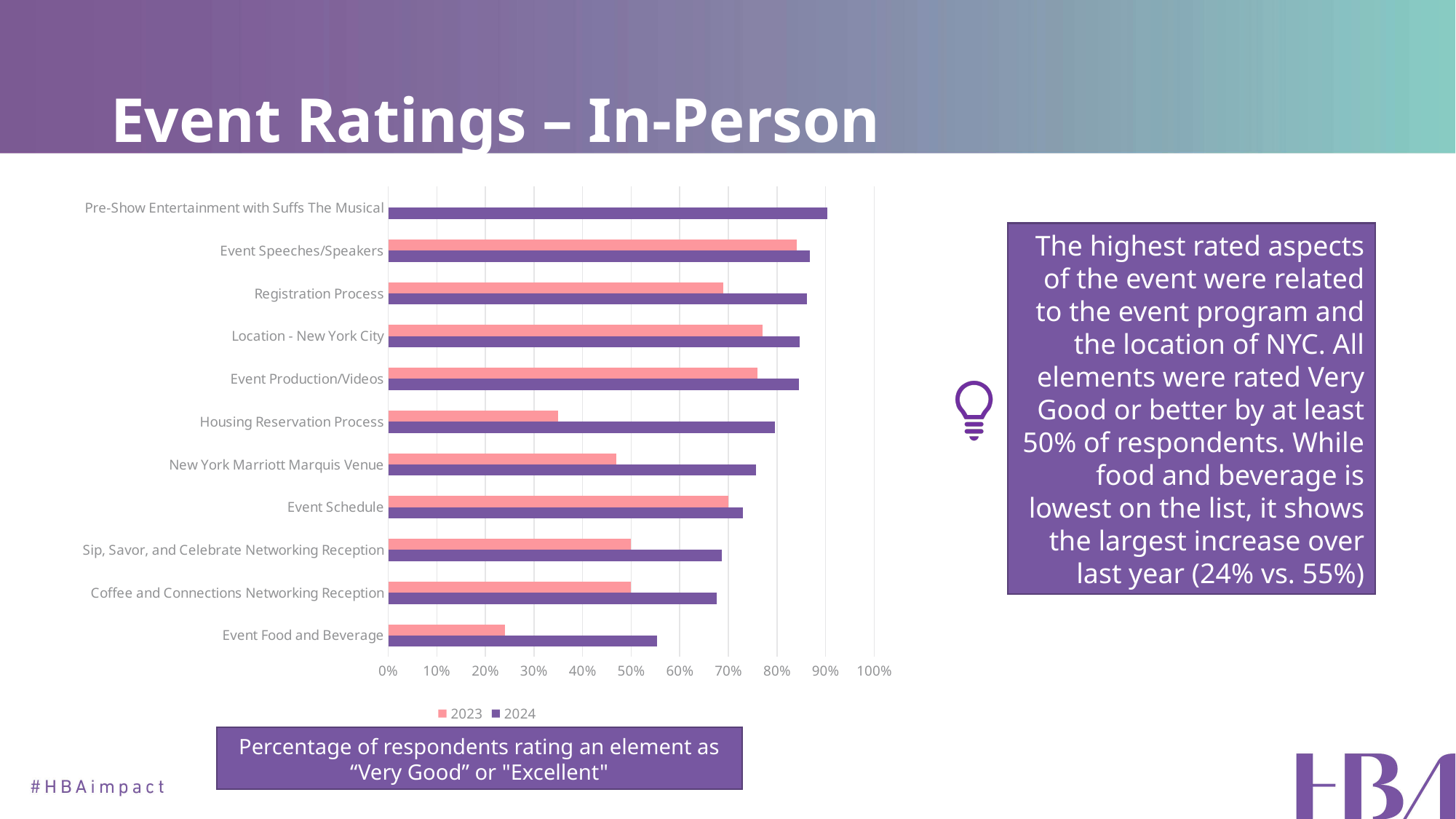
Is the 2024 value for Event Food and Beverage greater or less than 50%? greater How many categories are plotted on the chart? 11 How many series does the chart's legend list? 2 Is the 2024 value for Registration Process greater or less than 80%? greater Which category has the lowest 2024 value? Event Food and Beverage Is the 2023 value for Housing Reservation Process greater or less than 40%? less Which category has the highest 2023 value? Event Speeches/Speakers Which category has a 2024 bar but no 2023 bar? Pre-Show Entertainment with Suffs The Musical What kind of chart is shown on the slide? bar chart For Housing Reservation Process, which is larger: the 2023 value or the 2024 value? 2024 Which category has the lowest 2023 value? Event Food and Beverage